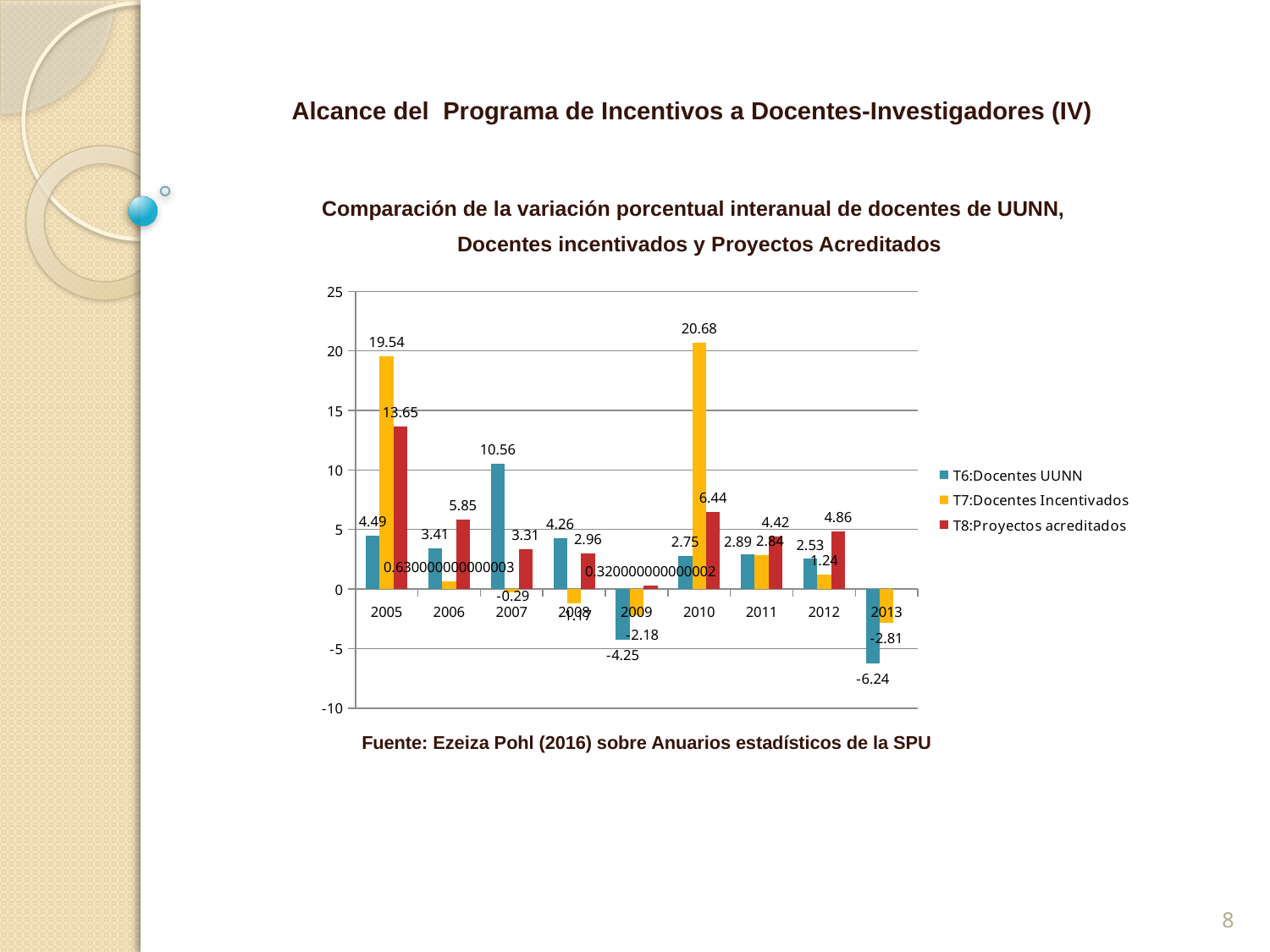
What is the value of T8:Proyectos acreditados in 2011? 4.42 Is the value for T7:Docentes Incentivados in 2005 greater or less than 15? greater What is the difference between T7:Docentes Incentivados and T8:Proyectos acreditados in 2005? 5.89 In which year does T7:Docentes Incentivados reach its highest value? 2010 What is the value of T6:Docentes UUNN in 2007? 10.56 In 2012, which is larger: T6:Docentes UUNN or T8:Proyectos acreditados? T8:Proyectos acreditados What is the value of T7:Docentes Incentivados in 2010? 20.68 How many series does the legend list? 3 What kind of chart is shown on the slide? bar chart What is the difference between T7:Docentes Incentivados and T8:Proyectos acreditados in 2010? 14.24 In which year does T6:Docentes UUNN have its lowest value? 2013 How many years are shown on the x axis of the chart? 9